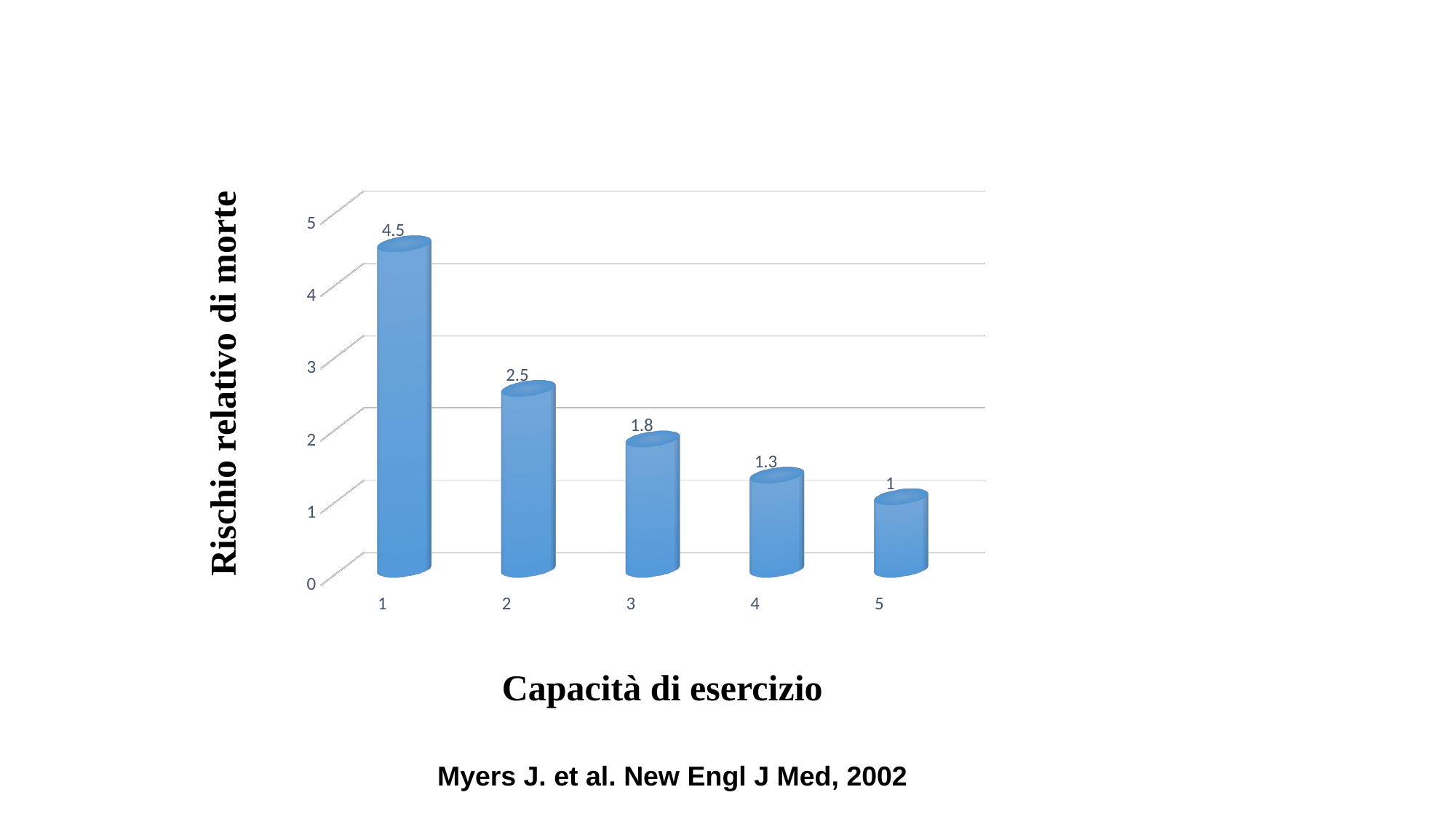
Which exercise capacity category has the highest relative risk of death? 1 What is the difference between the values for category 3 and category 4? 0.5 What is the label of the y axis? Rischio relativo di morte What is the difference between the values for category 1 and category 2? 2 Which exercise capacity category has the lowest relative risk of death? 5 Do the values rise or fall as exercise capacity increases along the x axis? fall What is the value for exercise capacity category 3? 1.8 Which is larger, the value for category 2 or the value for category 4? category 2 What kind of chart is shown on the slide? bar chart What is the value for exercise capacity category 5? 1 What is the value for exercise capacity category 1? 4.5 How many categories are shown on the x axis? 5